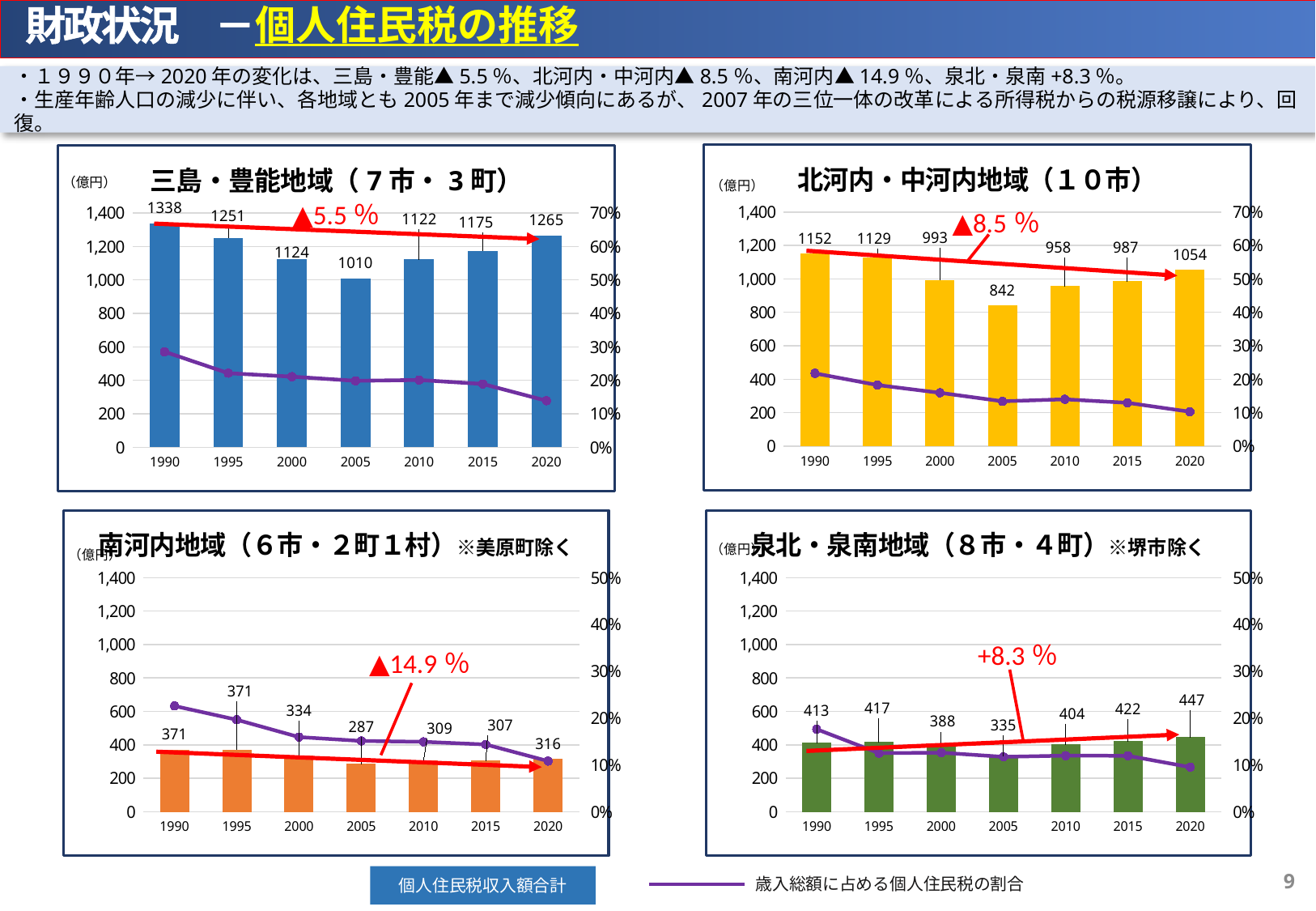
In the 三島・豊能地域（７市・３町） chart, is the purple line value for 1990 greater or less than 20%? greater What kind of chart is used for the 個人住民税収入額合計 values in the 泉北・泉南地域（８市・４町） chart? bar chart In the 三島・豊能地域（７市・３町） chart, what is the bar value for 1990? 1338 In the 北河内・中河内地域（１０市） chart, which year has the highest bar value? 1990 In the 南河内地域（６市・２町１村） chart, what is the bar value for 2020? 316 In the 泉北・泉南地域（８市・４町） chart, which year has the highest bar value? 2020 In the 南河内地域（６市・２町１村） chart, which year has the lowest bar value? 2005 How many years are plotted on the x axis of the 南河内地域（６市・２町１村） chart? 7 In the 泉北・泉南地域（８市・４町） chart, is the bar value for 2010 larger or smaller than the bar value for 2015? smaller In the 三島・豊能地域（７市・３町） chart, which year has the lowest bar value? 2005 In the 北河内・中河内地域（１０市） chart, what is the bar value for 2005? 842 In the 北河内・中河内地域（１０市） chart, what is the difference between the bar values for 1990 and 2020? 98